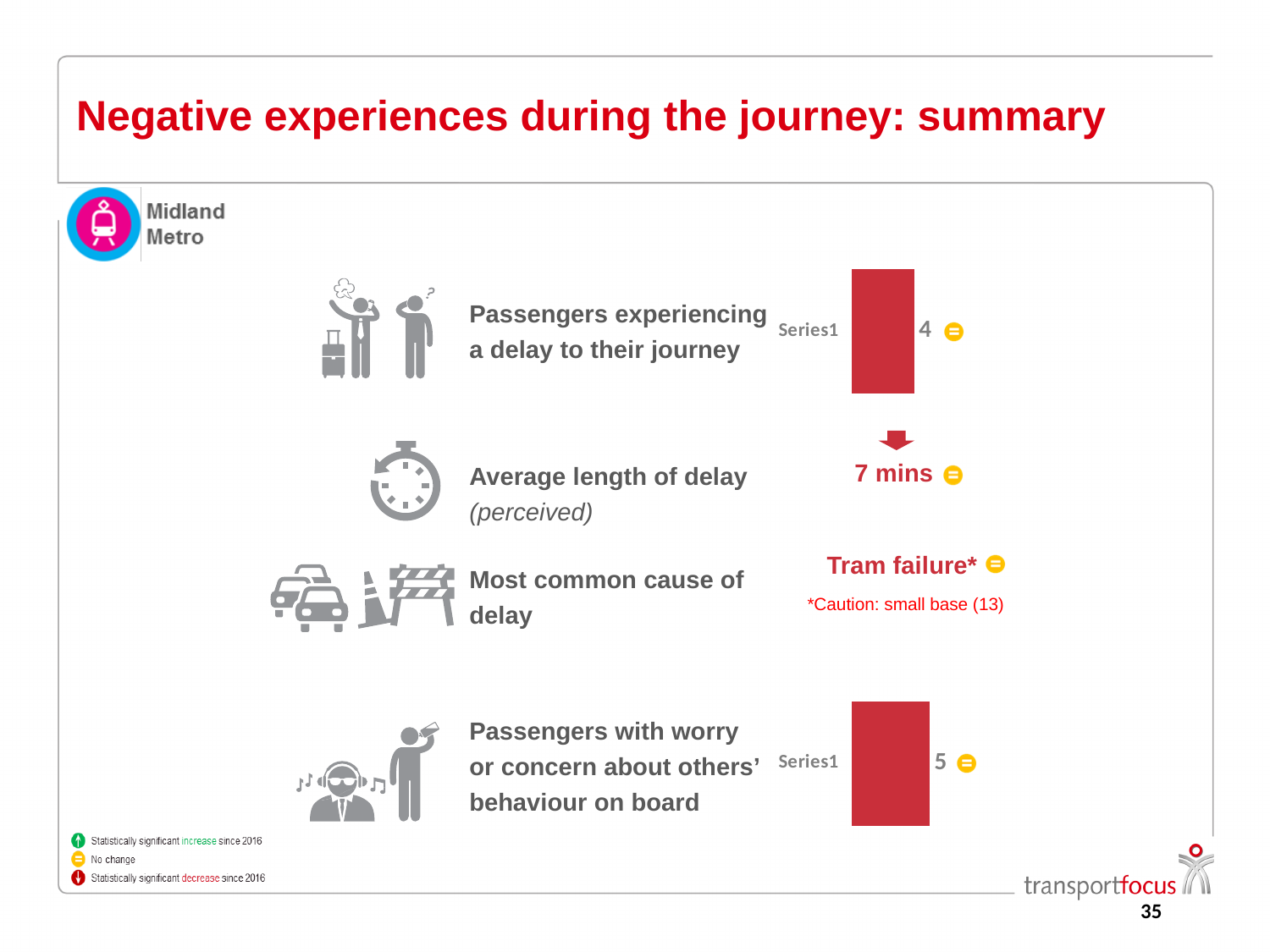
In the chart next to 'Passengers with worry or concern about others' behaviour on board', what value is shown for Series1? 5 Which is larger: the value in the chart for passengers experiencing a delay or the value in the chart for passengers with worry or concern about others' behaviour? passengers with worry or concern about others' behaviour How many bars are plotted in the chart next to 'Passengers experiencing a delay to their journey'? 1 In the chart next to 'Passengers experiencing a delay to their journey', what value is shown for Series1? 4 What is the difference between the value in the chart for passengers with worry or concern about others' behaviour (5) and the value in the chart for passengers experiencing a delay (4)? 1 What is the category label shown beside the bar in the chart next to 'Passengers experiencing a delay to their journey'? Series1 How many bars are plotted in the chart next to 'Passengers with worry or concern about others' behaviour on board'? 1 What kind of chart is shown next to 'Passengers with worry or concern about others' behaviour on board'? bar chart What colour are the bars in the two charts on the slide? red What kind of chart is shown next to 'Passengers experiencing a delay to their journey'? bar chart